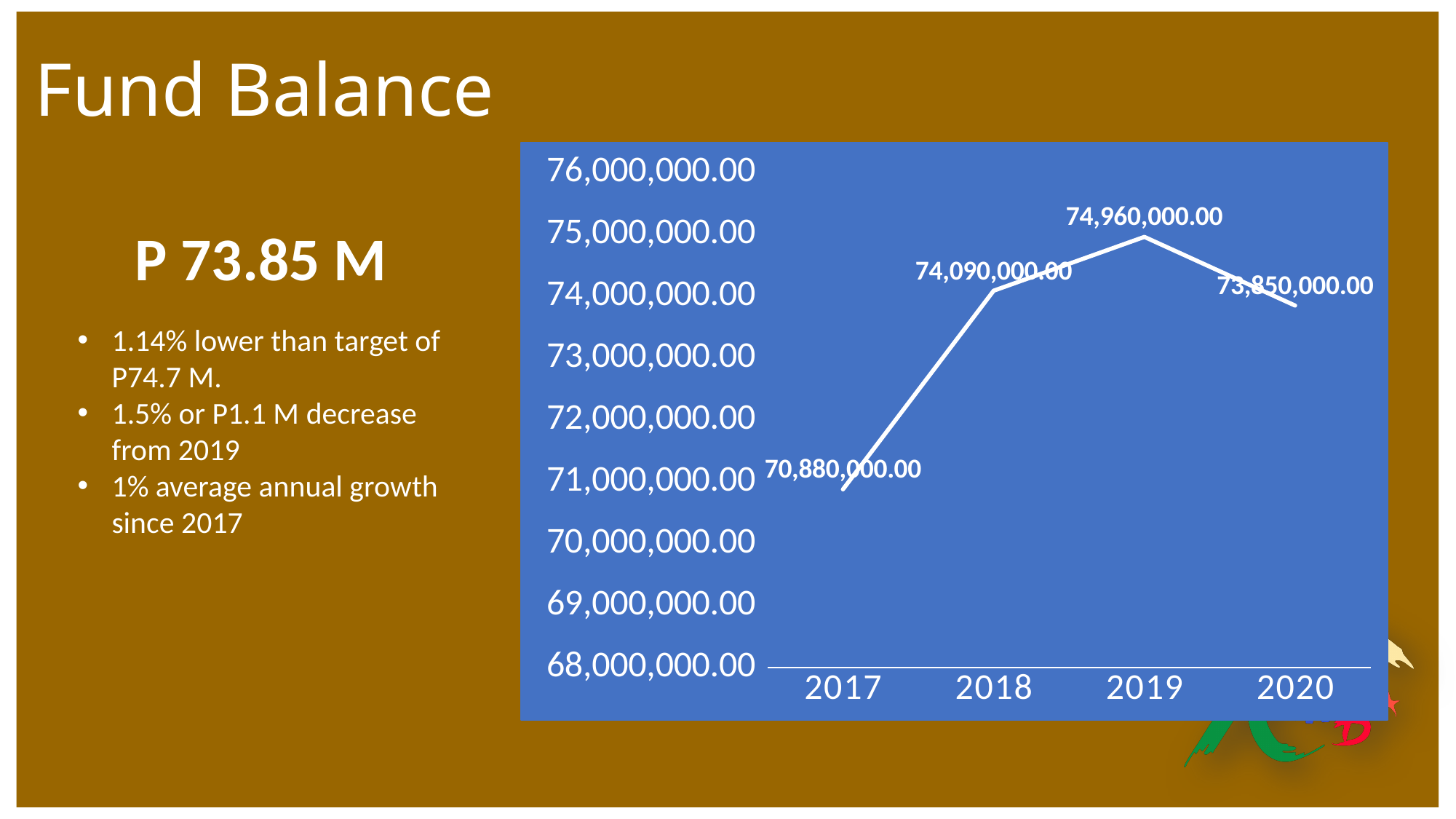
What is the difference between the fund balance in 2018 and in 2017? 3,210,000.00 Which year has the lowest fund balance? 2017 What is the fund balance value for 2019? 74,960,000.00 What is the fund balance value for 2018? 74,090,000.00 How many years are plotted on the chart? 4 What is the fund balance value for 2020? 73,850,000.00 Is the fund balance for 2017 greater or less than 72,000,000.00? less Which year has the highest fund balance? 2019 What kind of chart is shown on the slide? line chart Which year has a larger fund balance, 2018 or 2020? 2018 What is the difference between the fund balance in 2019 and in 2020? 1,110,000.00 What is the fund balance value for 2017? 70,880,000.00